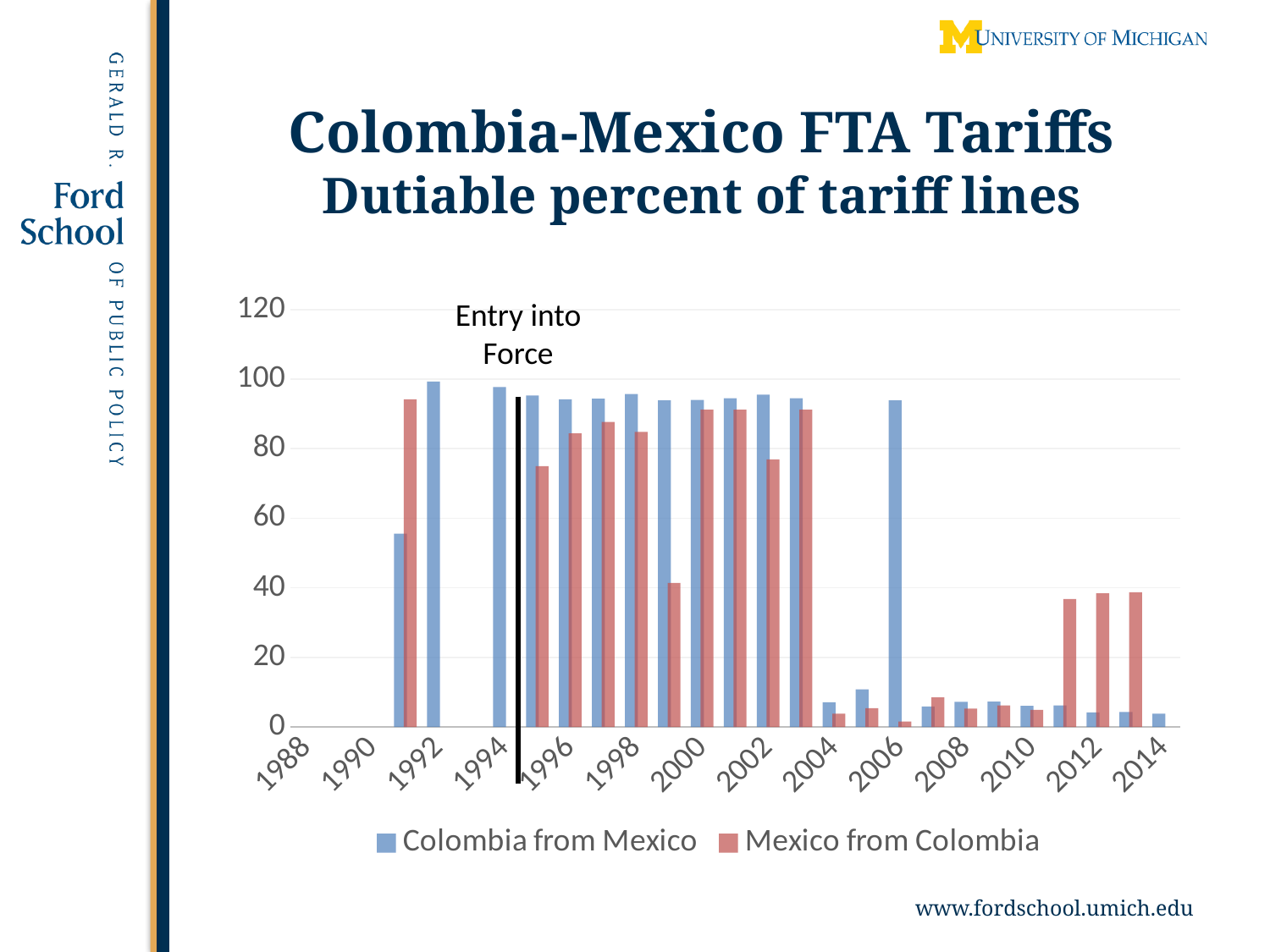
Is the value for Colombia from Mexico in 2014 greater or less than 20? less In 2006, which series has the larger value, Colombia from Mexico or Mexico from Colombia? Colombia from Mexico Is the value for Mexico from Colombia in 2000 greater or less than 80? greater Is the value for Mexico from Colombia in 2012 greater or less than 20? greater How many series does the legend list? 2 What are the two series named in the legend? Colombia from Mexico; Mexico from Colombia What kind of chart is shown on the slide? bar chart What does the text annotation next to the vertical black line say? Entry into Force Does the Colombia from Mexico value rise or fall from 2002 to 2014? fall In 2012, which series has the larger value, Colombia from Mexico or Mexico from Colombia? Mexico from Colombia